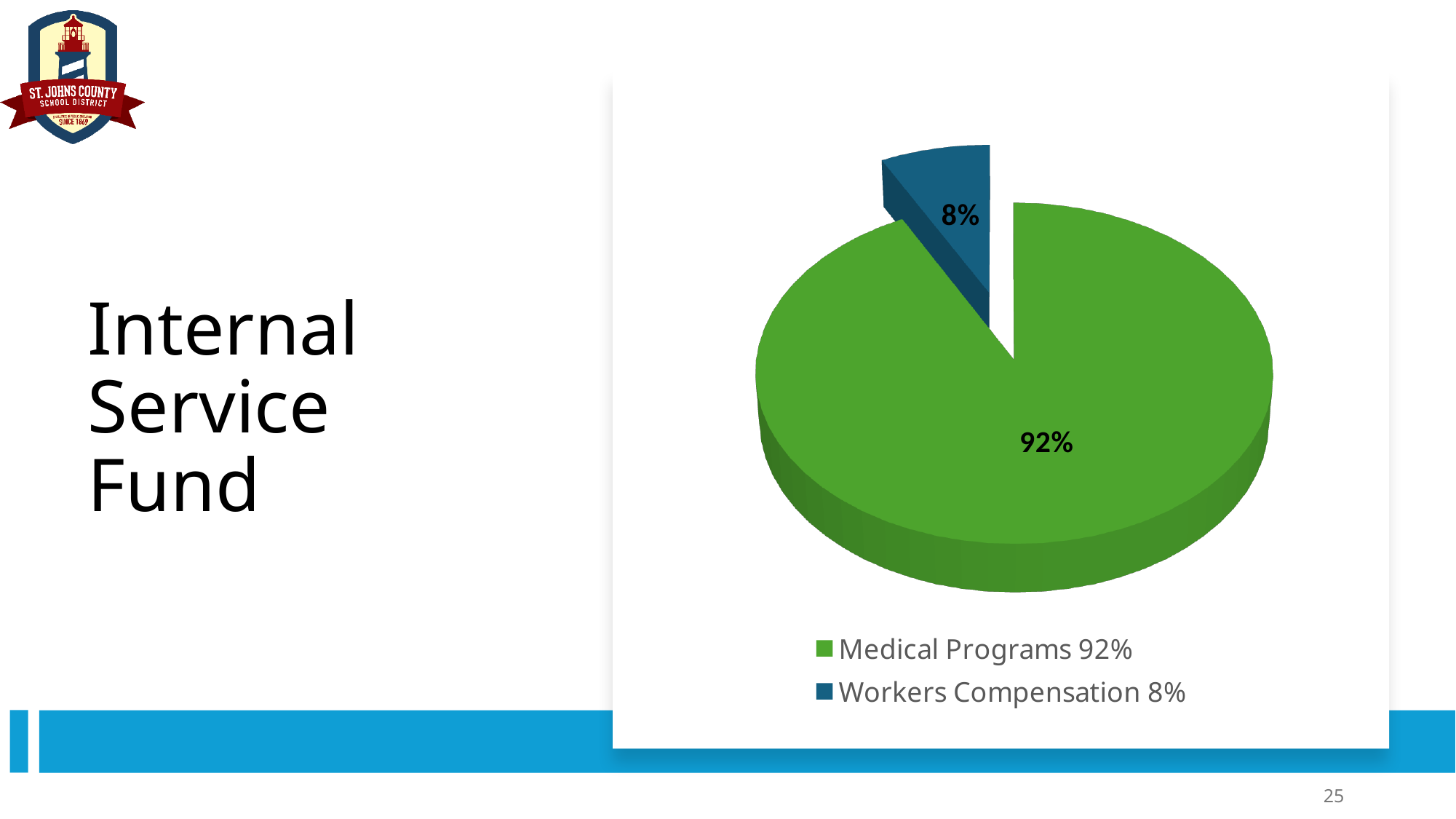
What colour is the Workers Compensation slice? Blue What is the difference in percentage points between Medical Programs and Workers Compensation? 84 Which category has the smallest slice of the pie? Workers Compensation Which is larger, the Medical Programs slice or the Workers Compensation slice? Medical Programs How many entries does the legend list? 2 What share of the pie does Medical Programs represent? 92% What share of the pie does Workers Compensation represent? 8% How many slices does the pie chart have? 2 What is the title text on the left of the slide next to the chart? Internal Service Fund Which category has the largest slice of the pie? Medical Programs What kind of chart is shown on the slide? Pie chart